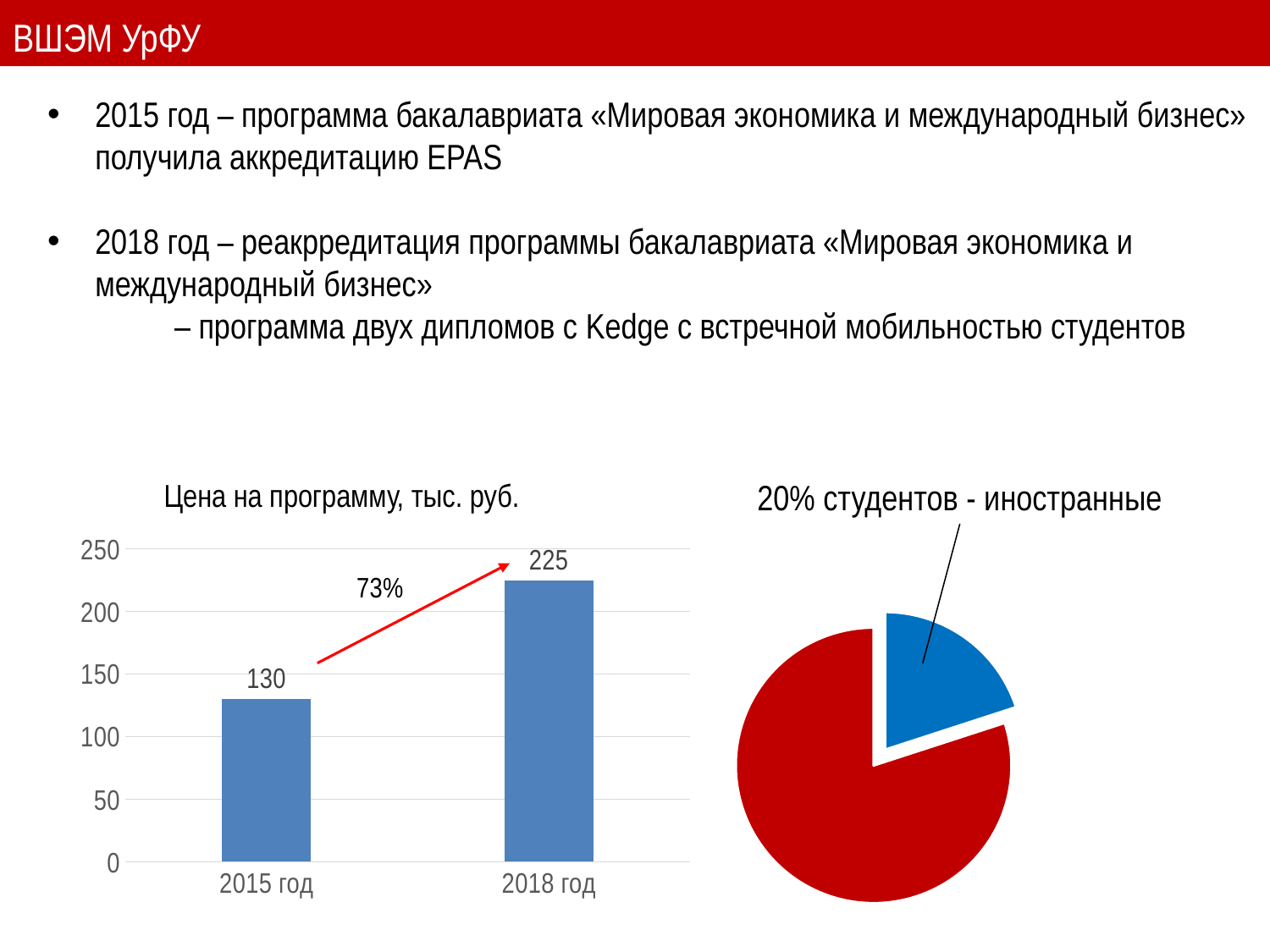
In the chart titled "Цена на программу, тыс. руб.", how many categories are shown on the x axis? 2 In the chart titled "Цена на программу, тыс. руб.", what percentage change is written next to the red arrow? 73% What kind of chart is the one titled "Цена на программу, тыс. руб."? bar chart In the chart titled "Цена на программу, тыс. руб.", what is the difference between the values for 2018 год and 2015 год? 95 In the chart titled "Цена на программу, тыс. руб.", what is the value for 2018 год? 225 In the chart titled "Цена на программу, тыс. руб.", which category has the highest value? 2018 год In the chart titled "Цена на программу, тыс. руб.", which is larger: the value for 2015 год or the value for 2018 год? 2018 год In the chart titled "Цена на программу, тыс. руб.", do the values rise or fall from 2015 год to 2018 год? rise In the pie chart on the right of the slide, what share of students does the blue slice labelled "иностранные" represent? 20% In the chart titled "Цена на программу, тыс. руб.", what is the value for 2015 год? 130 In the chart titled "Цена на программу, тыс. руб.", which category has the lowest value? 2015 год In the chart titled "Цена на программу, тыс. руб.", is the value for 2015 год greater or less than 150? less